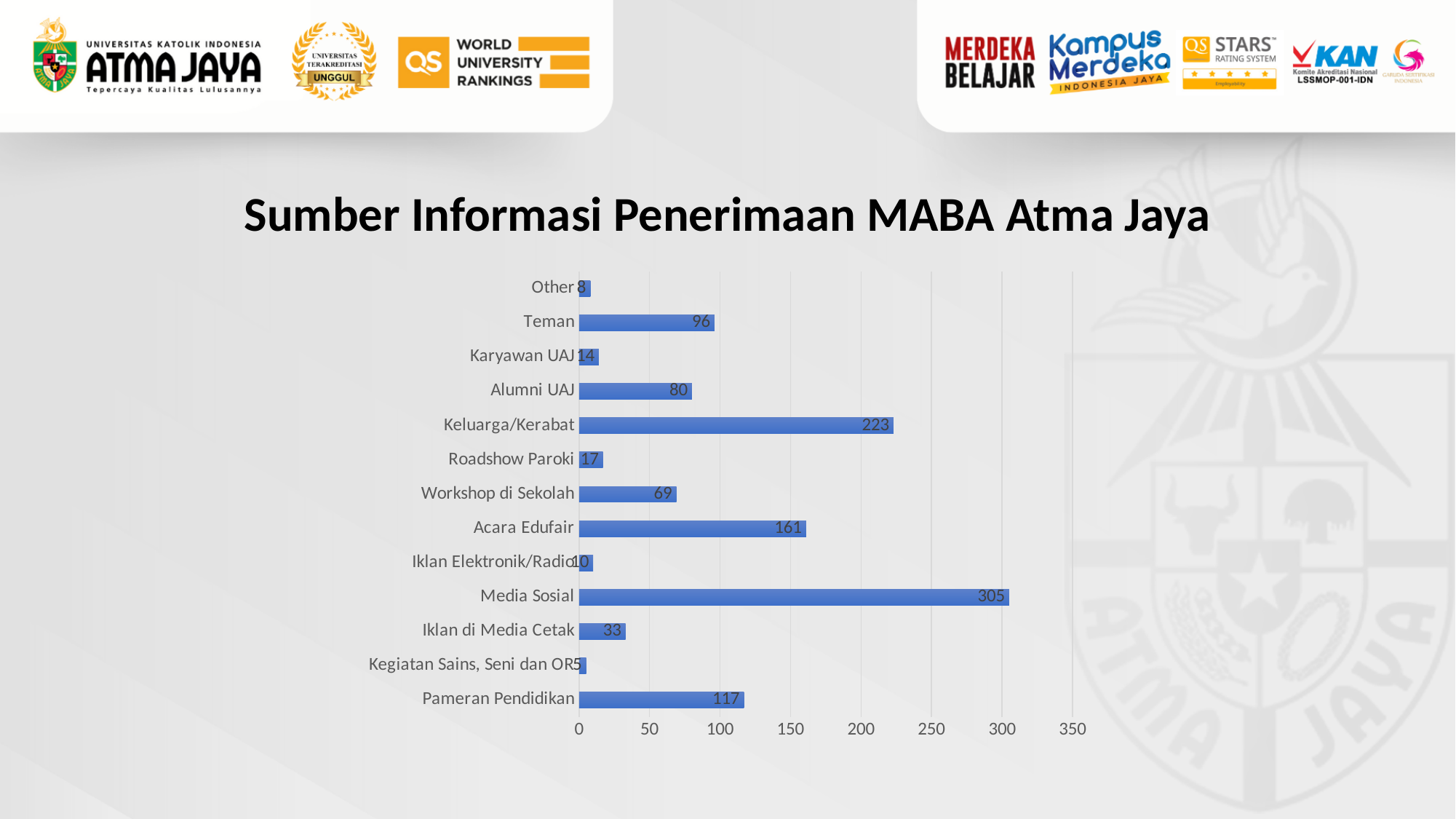
What is the value for Media Sosial? 305 Is the value for Acara Edufair greater or less than 150? greater Which category has the highest value? Media Sosial What is the value for Workshop di Sekolah? 69 What is the title of the slide? Sumber Informasi Penerimaan MABA Atma Jaya Which category has the lowest value? Kegiatan Sains, Seni dan OR Which is larger, the value for Teman or the value for Alumni UAJ? Teman What is the value for Keluarga/Kerabat? 223 What is the value for Pameran Pendidikan? 117 What kind of chart is shown on the slide? Bar chart How many categories are shown in the chart? 13 What is the difference between the values for Media Sosial and Keluarga/Kerabat? 82